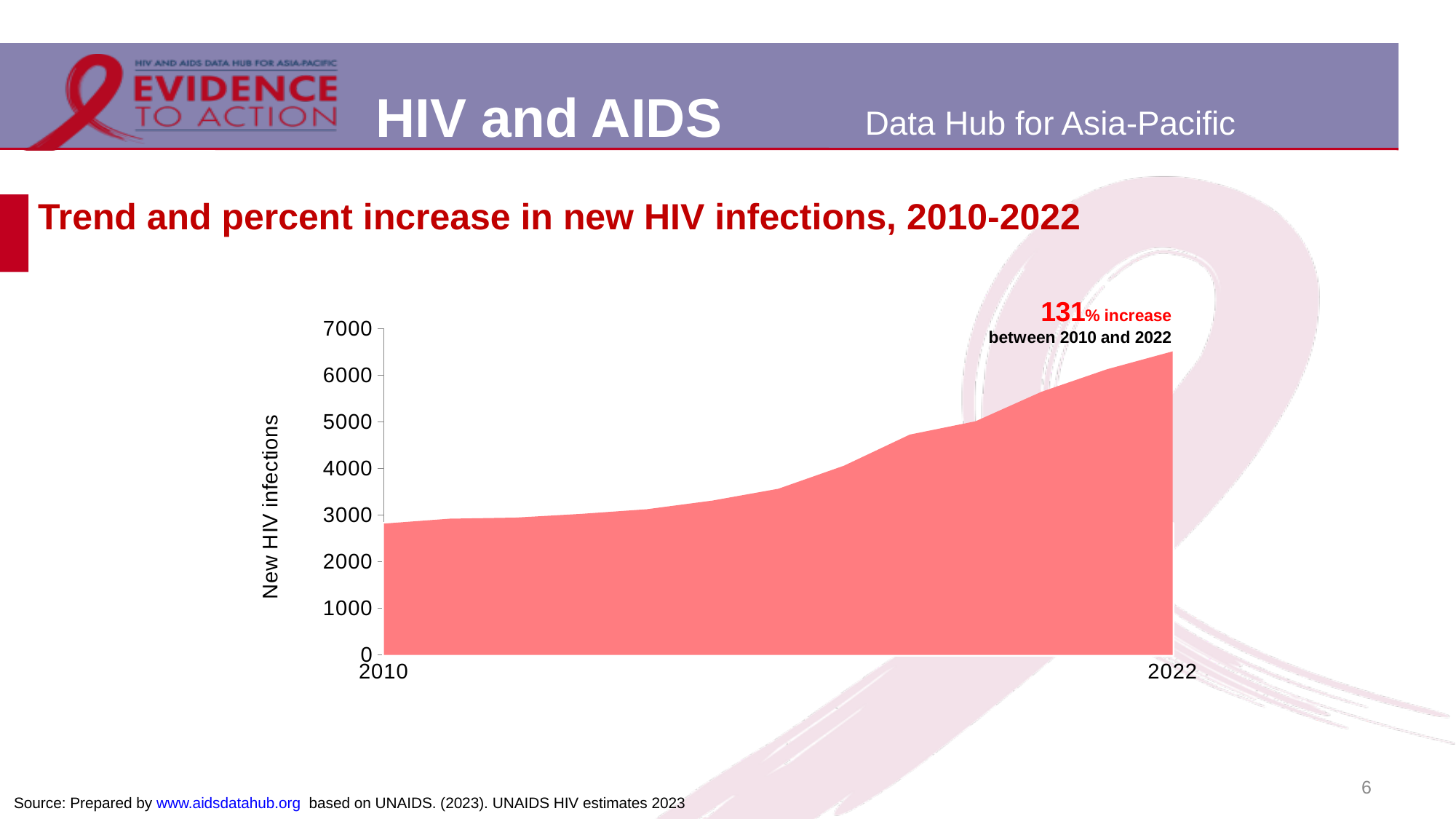
Do new HIV infections rise or fall from 2010 to 2022? Rise In which year is the number of new HIV infections highest? 2022 What percent increase in new HIV infections between 2010 and 2022 is stated on the chart? 131% Is the value for 2022 greater or less than 7000? less What is the label on the y-axis of the chart? New HIV infections Is the value for 2010 greater or less than 4000? less In which year is the number of new HIV infections lowest? 2010 What kind of chart is shown on the slide? Area chart Is the value for 2022 greater or less than 6000? greater What is the title of the chart on the slide? Trend and percent increase in new HIV infections, 2010-2022 Which year has the larger number of new HIV infections, 2010 or 2022? 2022